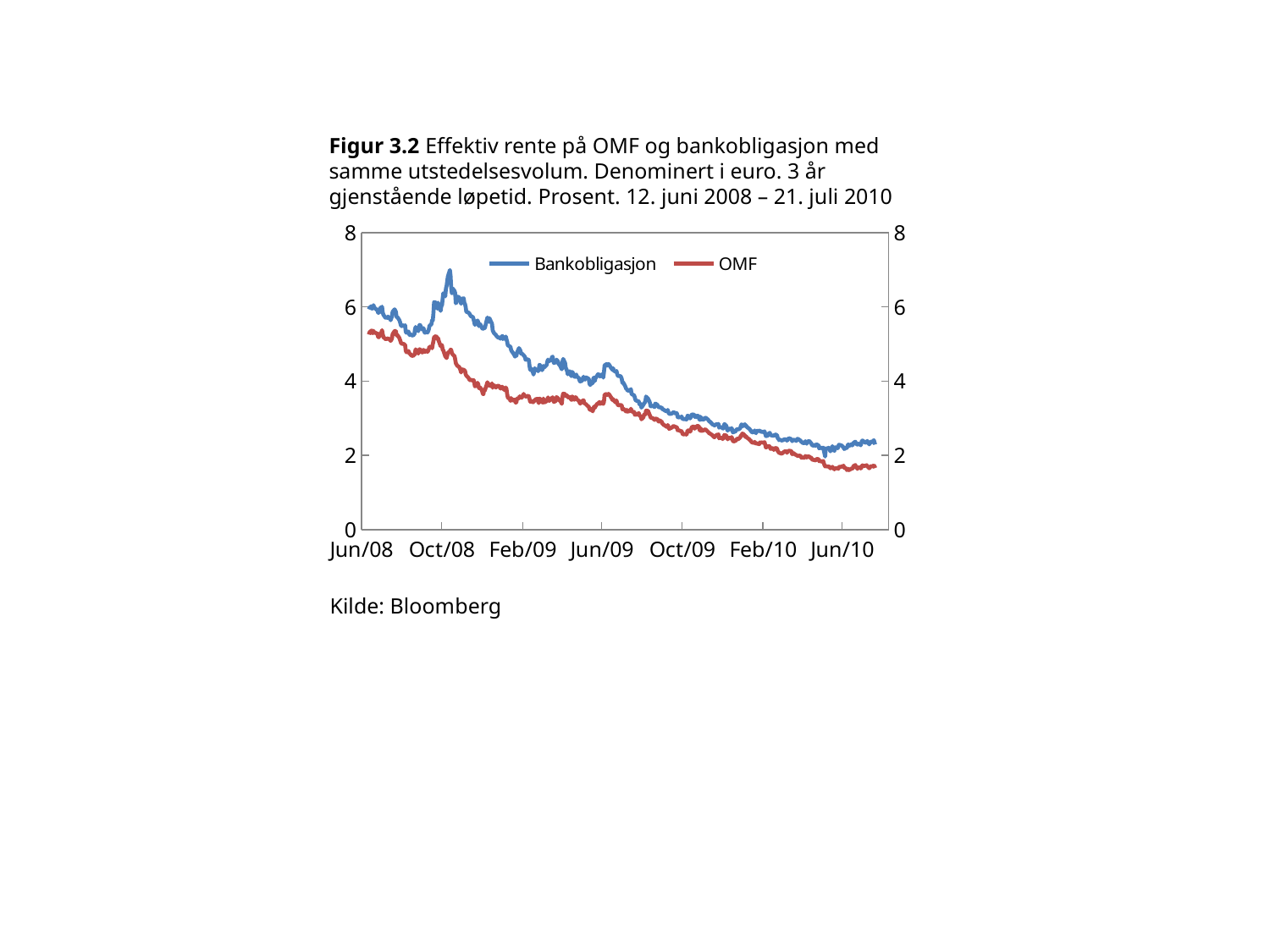
Which series reaches the highest value on the chart? Bankobligasjon What kind of chart is shown on the slide? line chart Which series is higher throughout the period, Bankobligasjon or OMF? Bankobligasjon Do the values for OMF generally rise or fall over the period shown? fall Is the value for OMF at Jun/08 greater or less than 4? greater Which two series are listed in the legend? Bankobligasjon and OMF Do the values for Bankobligasjon generally rise or fall from Jun/08 to Jun/10? fall Is the peak value for Bankobligasjon around Oct/08 greater or less than 6? greater What is the source given below the chart? Bloomberg Is the value for OMF at Jun/10 greater or less than 2? less How many series does the legend list? 2